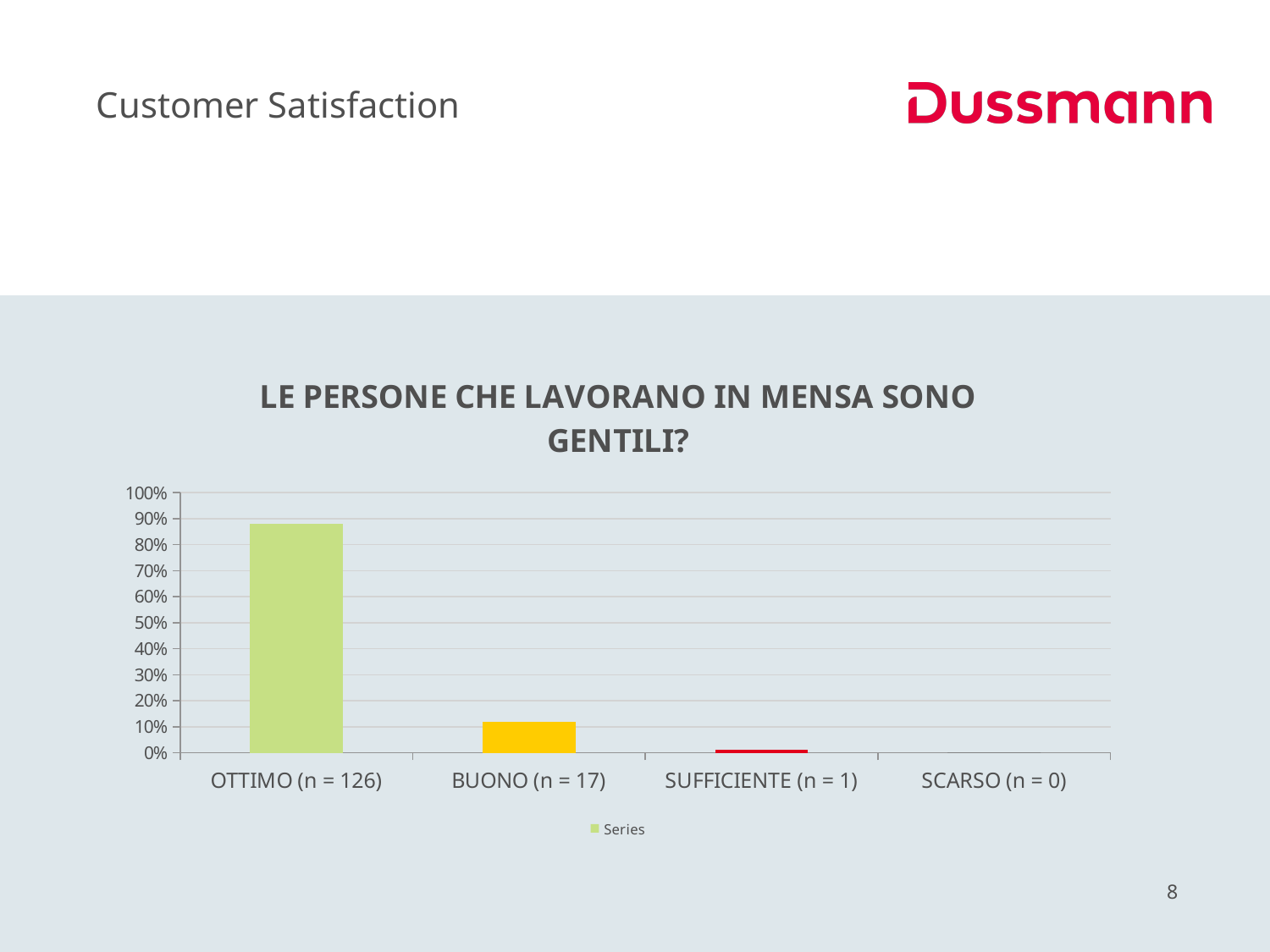
Is the value for BUONO (n = 17) greater or less than 20%? less How many series does the legend list? 1 What type of chart is shown on the slide? bar chart Is the value for OTTIMO (n = 126) greater or less than 80%? greater Do the values rise or fall from left to right along the x axis? fall Is the value for SUFFICIENTE (n = 1) greater or less than 10%? less Which category has the lowest value? SCARSO (n = 0) Which is larger, the value for OTTIMO (n = 126) or the value for BUONO (n = 17)? OTTIMO (n = 126) How many categories are shown on the x axis of the chart? 4 What is the title of the chart? LE PERSONE CHE LAVORANO IN MENSA SONO GENTILI? What is the name of the series shown in the legend? Series Which category has the highest value? OTTIMO (n = 126)